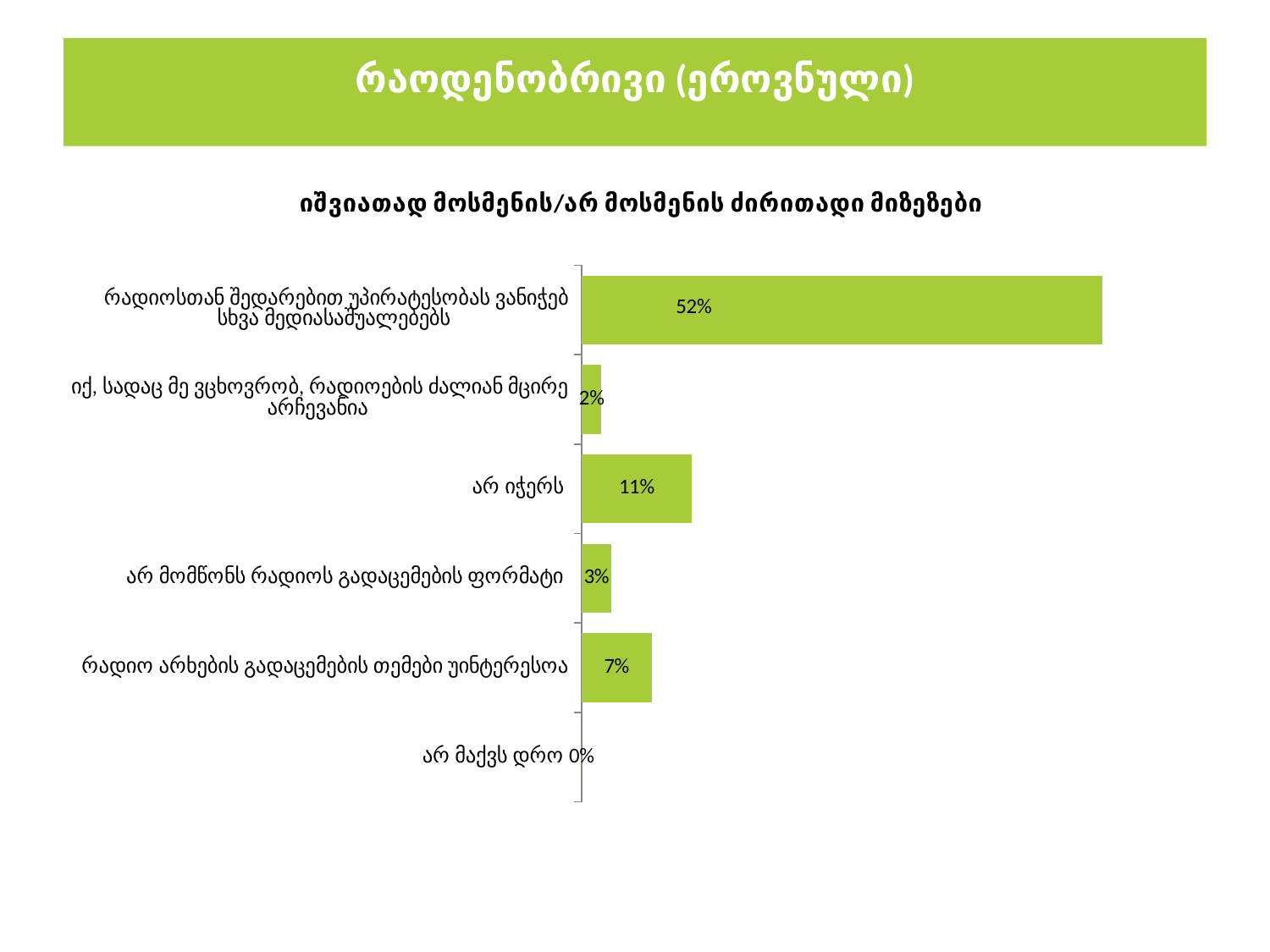
What is the title of the chart? იშვიათად მოსმენის/არ მოსმენის ძირითადი მიზეზები What type of chart is shown on the slide? bar chart What is the value for "არ მაქვს დრო"? 0% What is the value for "არ იჭერს"? 11% What is the value for "არ მომწონს რადიოს გადაცემების ფორმატი"? 3% Which category has the lowest value? არ მაქვს დრო What is the difference between the value for "რადიოსთან შედარებით უპირატესობას ვანიჭებ სხვა მედიასაშუალებებს" and the value for "არ იჭერს"? 41% What is the value for "რადიო არხების გადაცემების თემები უინტერესოა"? 7% Which is larger: the value for "არ იჭერს" or the value for "რადიო არხების გადაცემების თემები უინტერესოა"? არ იჭერს What is the difference between the value for "რადიო არხების გადაცემების თემები უინტერესოა" and the value for "იქ, სადაც მე ვცხოვრობ, რადიოების ძალიან მცირე არჩევანია"? 5% How many categories are shown in the chart? 6 Which category has the highest value? რადიოსთან შედარებით უპირატესობას ვანიჭებ სხვა მედიასაშუალებებს